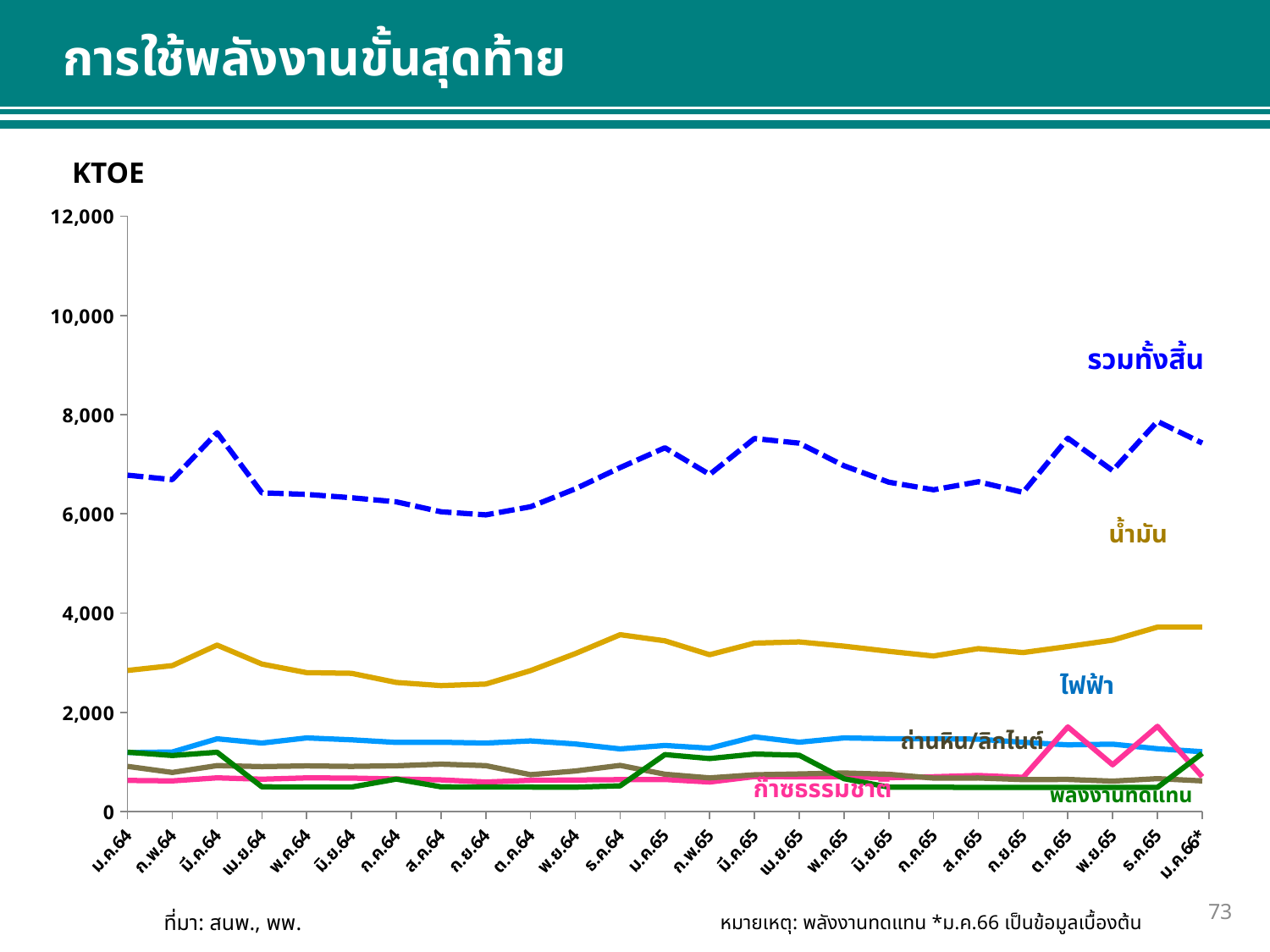
Is the value for รวมทั้งสิ้น in ธ.ค.65 greater or less than 8,000? less Does the รวมทั้งสิ้น line rise or fall from มี.ค.64 to ก.ย.64? fall What unit is shown above the y axis? KTOE What kind of chart is shown on the slide? line chart Is the value for น้ำมัน in ธ.ค.64 greater or less than 2,000? greater How many months are shown along the x axis? 25 Is the value for รวมทั้งสิ้น in ม.ค.64 greater or less than 6,000? greater In ม.ค.65, which is larger: น้ำมัน or ไฟฟ้า? น้ำมัน How many data series are labelled on the chart? 6 Which series is drawn as a dashed line? รวมทั้งสิ้น Which series has the highest values throughout the chart? รวมทั้งสิ้น